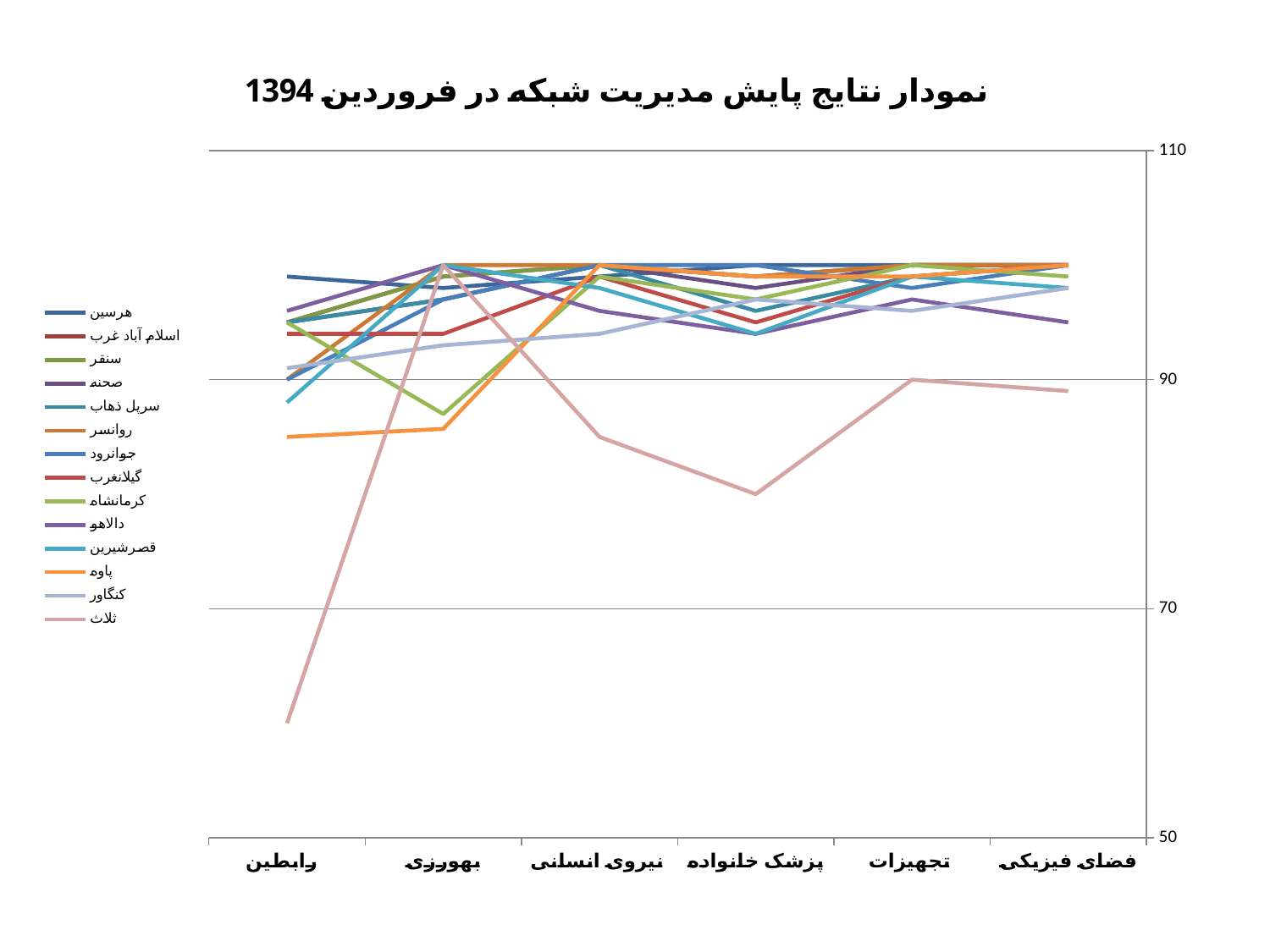
How many categories are shown along the x axis? 6 Which is larger at روابطین: the value for هرسین or the value for ثلاث? هرسین Is the value for ثلاث at پزشک خانواده greater or less than 90? less Is the value for ثلاث at بهورزی greater or less than 90? greater How many series does the legend list? 14 What is the title of the chart? نمودار نتایج پایش مدیریت شبکه در فروردین 1394 Is the value for ثلاث at روابطین greater or less than 70? less Does the value for ثلاث rise or fall from روابطین to بهورزی? rise Which series has the lowest value at روابطین? ثلاث What kind of chart is shown on the slide? line chart